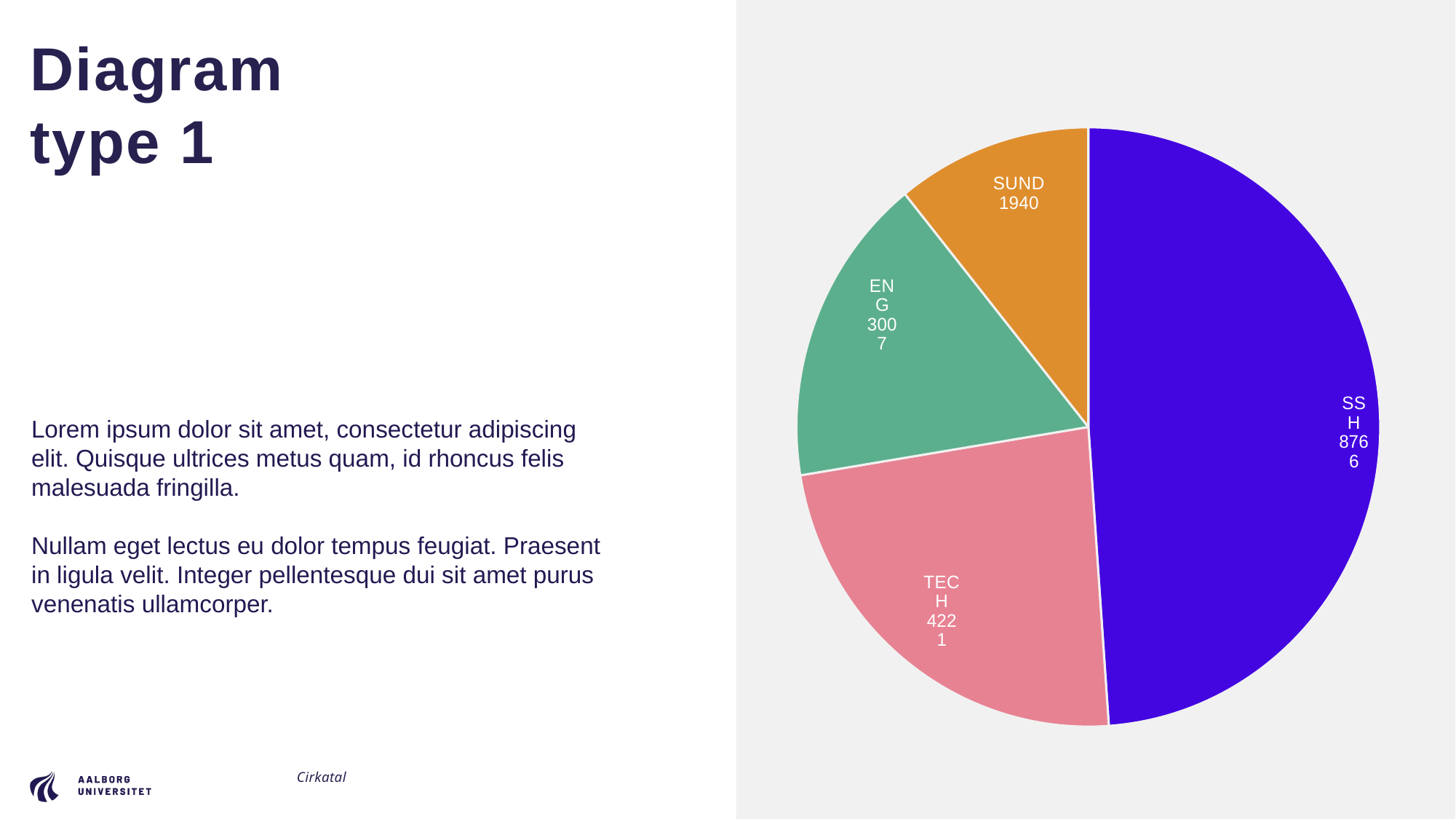
Which slice of the pie chart has the lowest value? SUND What is the difference between the values for SSH and TECH? 4545 Which is larger, the value for TECH or the value for ENG? TECH What is the value for SSH in the pie chart? 8766 What is the value for SUND in the pie chart? 1940 What is the value for ENG in the pie chart? 3007 How many slices does the pie chart have? 4 Which slice of the pie chart has the highest value? SSH What is the difference between the values for ENG and SUND? 1067 What is the total of all slices in the pie chart? 17934 What kind of chart is shown on the slide? pie chart What is the value for TECH in the pie chart? 4221